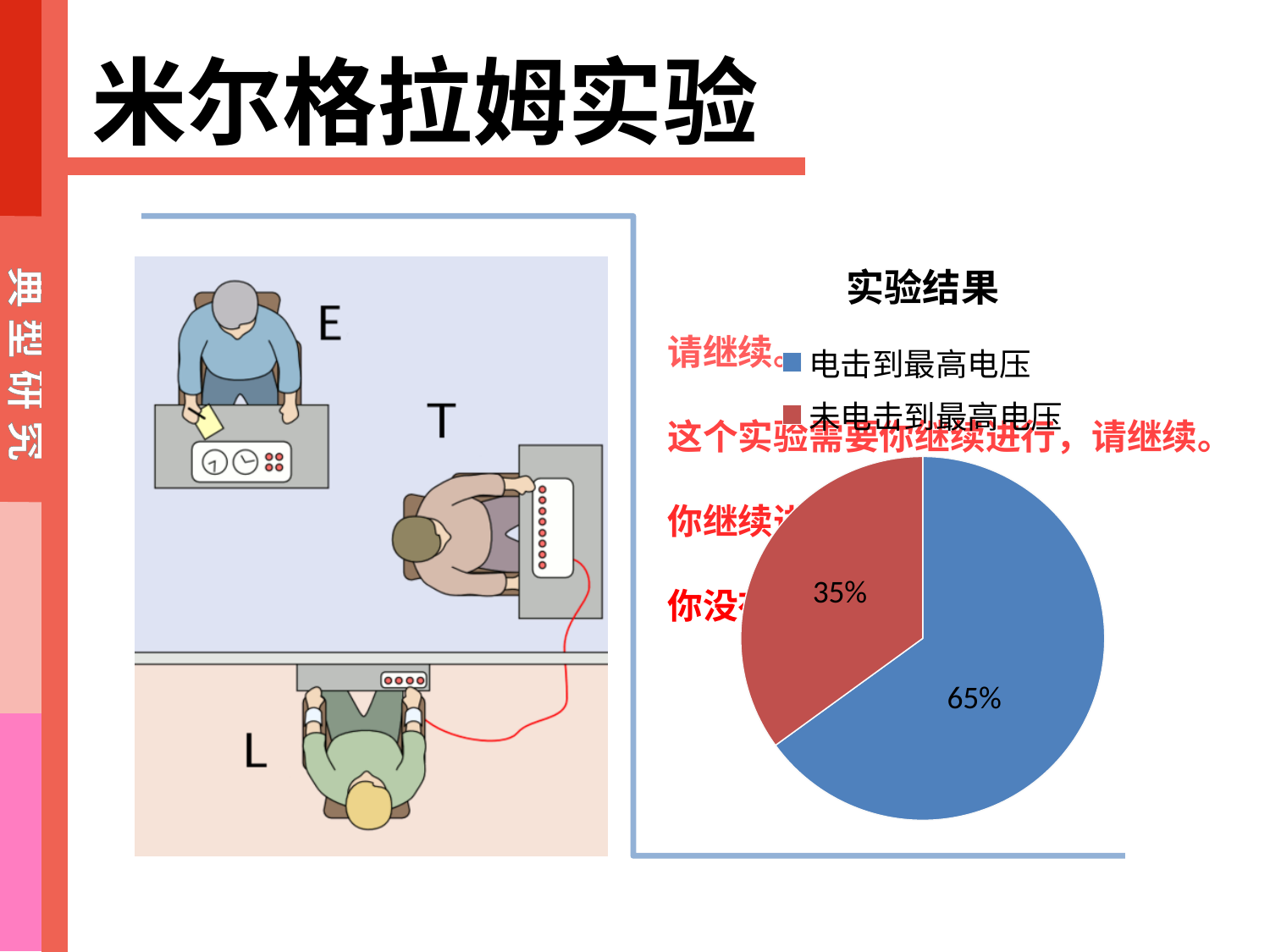
What is the title of the chart? 实验结果 What colour is the 电击到最高电压 slice? blue What kind of chart is shown on the slide? pie chart How many entries does the legend list? 2 How many slices does the pie chart have? 2 What percentage of the pie is labelled 未电击到最高电压? 35% What is the difference in percentage points between the 电击到最高电压 slice and the 未电击到最高电压 slice? 30 What percentage of the pie is labelled 电击到最高电压? 65% Which is larger, the 电击到最高电压 slice or the 未电击到最高电压 slice? 电击到最高电压 Which slice of the pie is the smallest? 未电击到最高电压 Which slice of the pie is the largest? 电击到最高电压 Is the value for 未电击到最高电压 greater or less than 50%? less